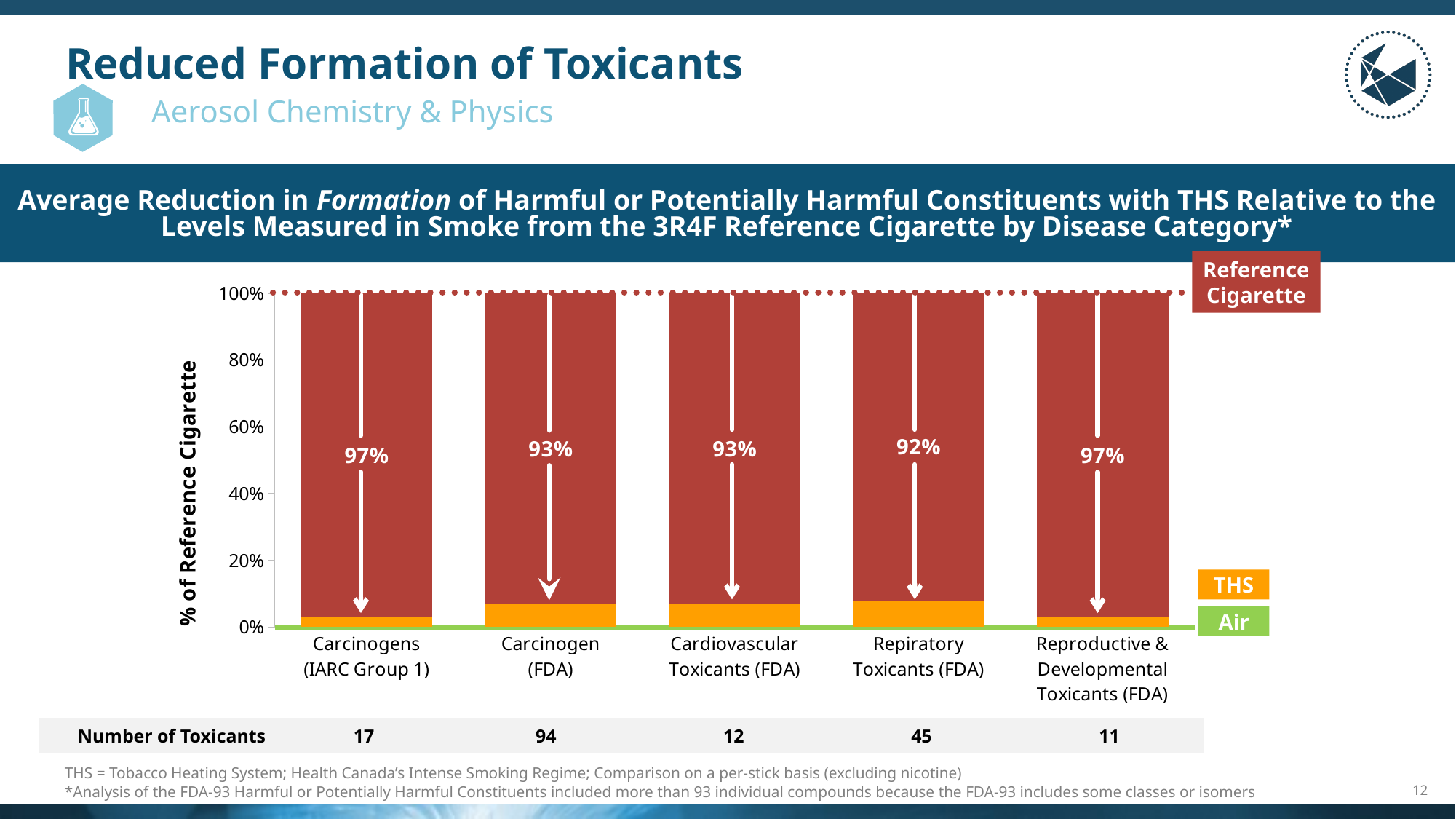
What kind of chart is shown on the slide? bar chart What is the average reduction shown for Cardiovascular Toxicants (FDA)? 93% Which has the larger reduction: Carcinogen (FDA) or Respiratory Toxicants (FDA)? Carcinogen (FDA) What is the average reduction shown for Respiratory Toxicants (FDA)? 92% What is the average reduction shown for Carcinogens (IARC Group 1)? 97% How many disease categories are shown on the chart? 5 What is the difference between the reduction for Reproductive & Developmental Toxicants (FDA) and the reduction for Respiratory Toxicants (FDA)? 5 percentage points What is the label on the y axis of the chart? % of Reference Cigarette How many toxicants are included in the Carcinogen (FDA) category? 94 Which disease category shows the smallest average reduction? Respiratory Toxicants (FDA) Is the THS value for Respiratory Toxicants (FDA) greater or less than 20% of the reference cigarette? less